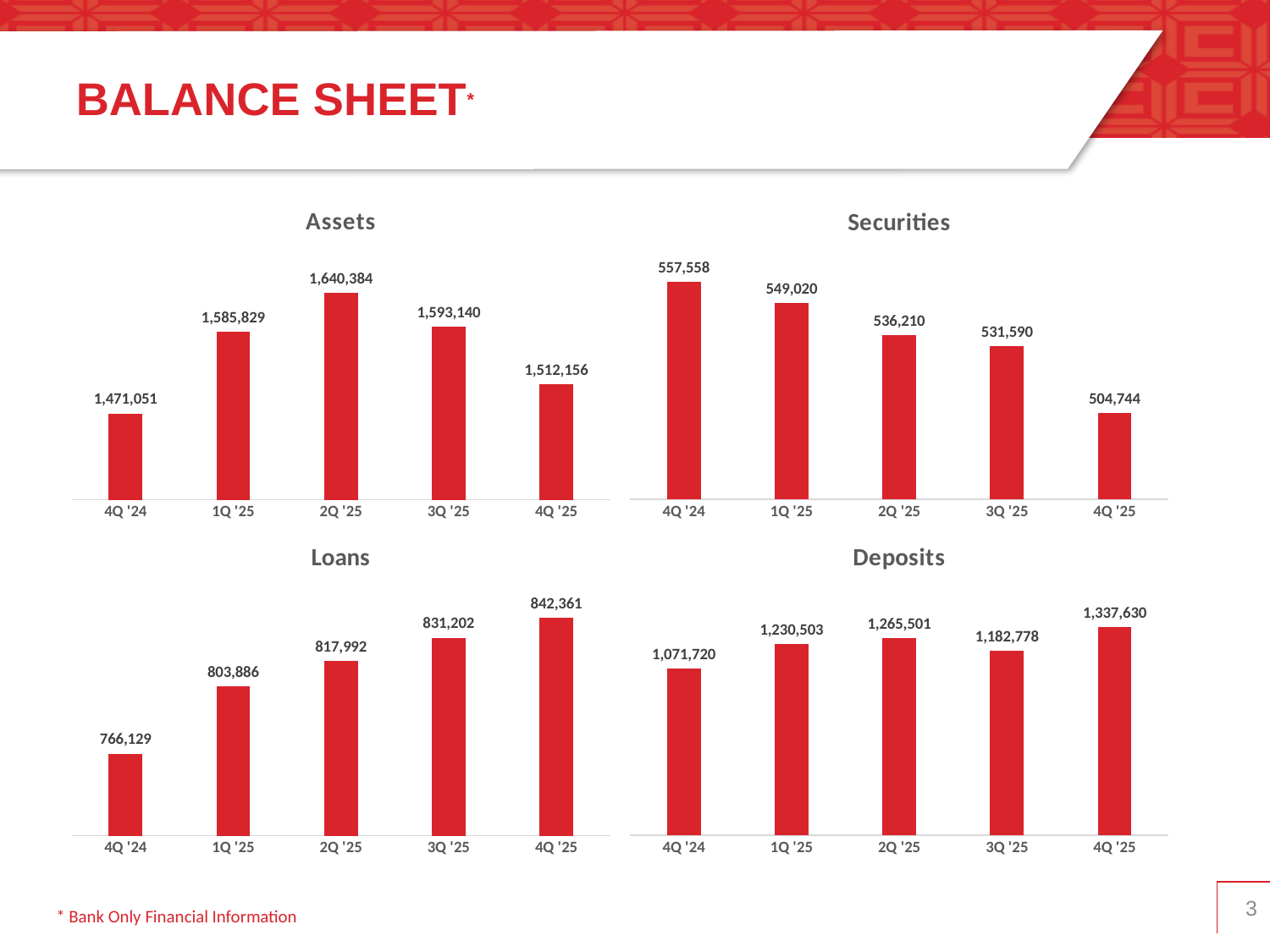
In the Assets chart, what is the value for 2Q '25? 1,640,384 What type of chart is the Assets chart? bar chart In the Loans chart, which quarter has the highest value? 4Q '25 In the Deposits chart, which is larger, the value for 1Q '25 or the value for 3Q '25? 1Q '25 In the Securities chart, what is the value for 4Q '25? 504,744 In the Securities chart, do the values rise or fall from 4Q '24 to 4Q '25? fall In the Securities chart, which quarter has the highest value? 4Q '24 In the Deposits chart, what is the value for 3Q '25? 1,182,778 In the Deposits chart, what is the difference between the 4Q '25 and 3Q '25 values? 154,852 How many quarters are shown in the Loans chart? 5 In the Loans chart, what is the difference between the 4Q '25 and 4Q '24 values? 76,232 In the Assets chart, which quarter has the lowest value? 4Q '24